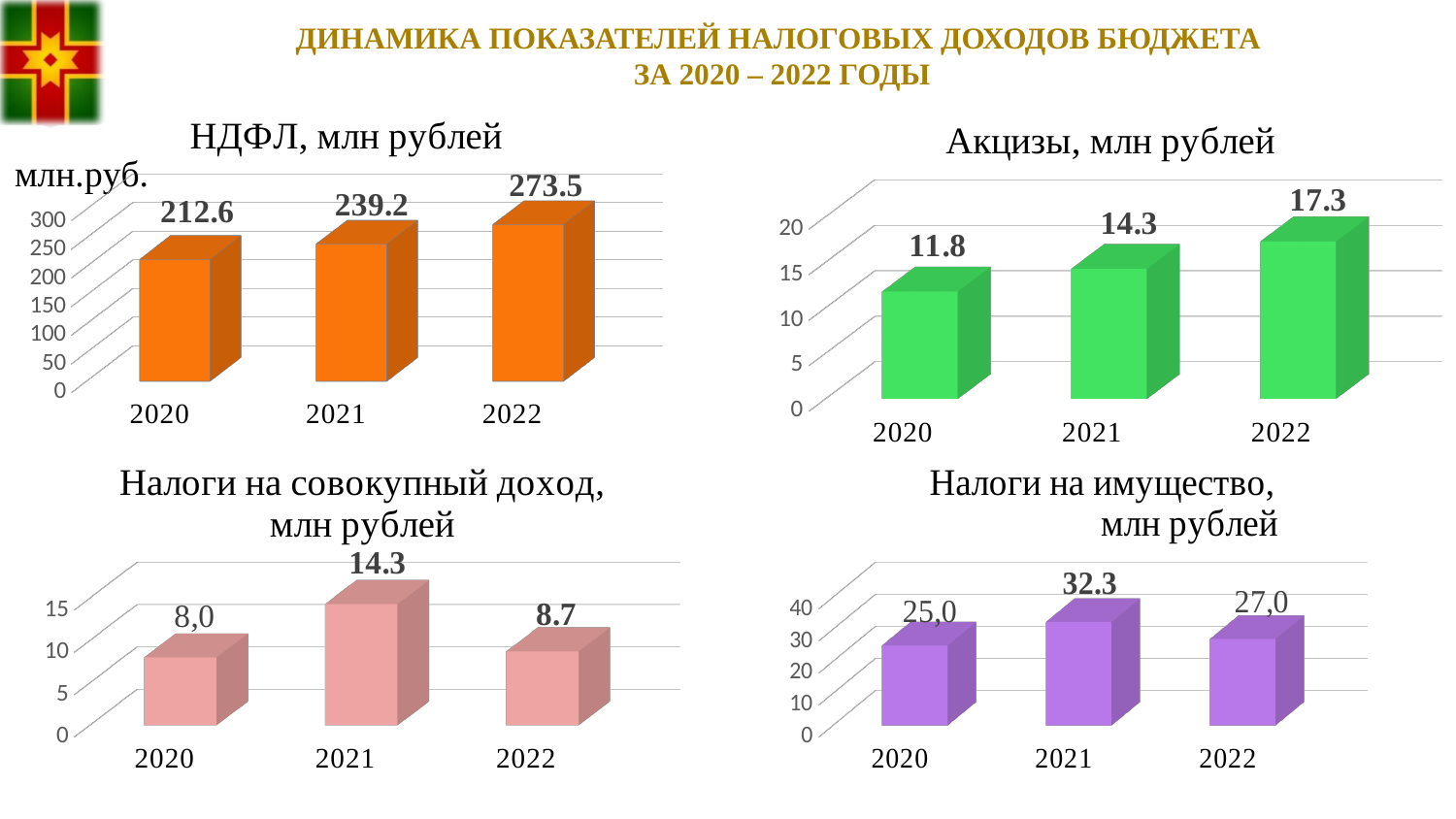
In the chart titled "НДФЛ, млн рублей", which year has the lowest value? 2020 In the chart titled "Налоги на совокупный доход, млн рублей", what is the value for 2021? 14.3 In the chart titled "Налоги на имущество, млн рублей", which is larger, the value for 2020 or the value for 2022? 2022 In the chart titled "Акцизы, млн рублей", what is the difference between the 2022 and 2020 values? 5.5 How many years are shown in the chart titled "Налоги на имущество, млн рублей"? 3 What kind of chart is the chart titled "Акцизы, млн рублей"? bar chart In the chart titled "Акцизы, млн рублей", do the values rise or fall from 2020 to 2022? rise In the chart titled "НДФЛ, млн рублей", what is the difference between the 2022 and 2020 values? 60.9 In the chart titled "Акцизы, млн рублей", what is the value for 2020? 11.8 In the chart titled "Налоги на совокупный доход, млн рублей", which year has the highest value? 2021 In the chart titled "НДФЛ, млн рублей", what is the value for 2022? 273.5 In the chart titled "Налоги на имущество, млн рублей", what is the value for 2022? 27,0